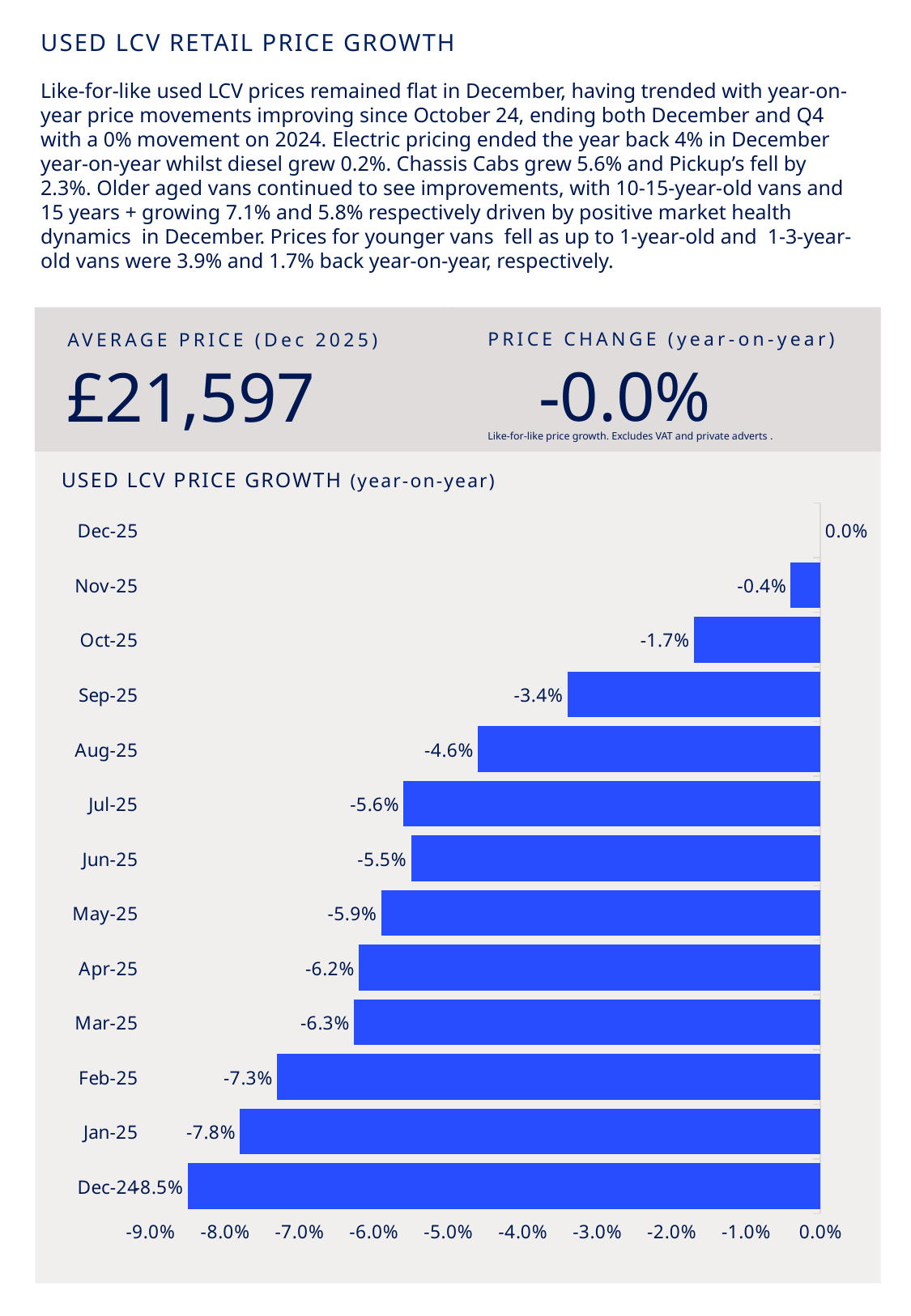
What is the year-on-year price growth value for Mar-25? -6.3% Which month has the lowest year-on-year price growth value in the chart? Dec-24 How many months are shown in the chart? 13 What is the year-on-year price growth value for Sep-25? -3.4% What is the year-on-year price growth value for Nov-25? -0.4% Which has the higher year-on-year price growth value, Aug-25 or Apr-25? Aug-25 What is the year-on-year price growth value for Jan-25? -7.8% What type of chart is shown under the heading USED LCV PRICE GROWTH (year-on-year)? Bar chart Do the year-on-year price growth values rise or fall from Dec-24 to Dec-25? Rise What is the difference between the values for Feb-25 and Jan-25? 0.5 percentage points Which month has the highest year-on-year price growth value in the chart? Dec-25 Is the value for Dec-24 greater or less than -8.0%? less